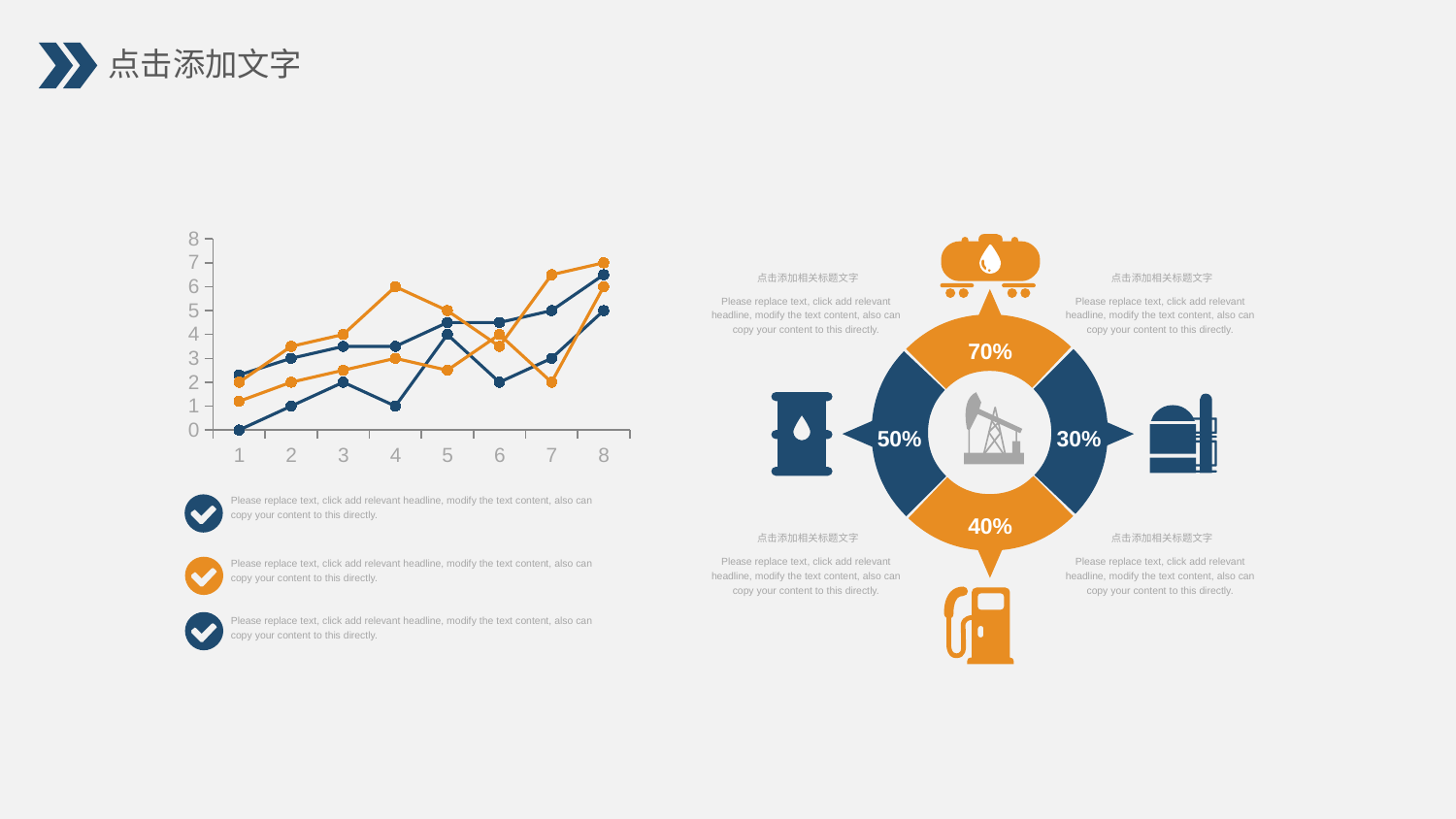
In the line chart on the left, do the lines generally rise or fall from x = 1 to x = 8? rise In the ring diagram on the right, what is the difference between the top segment (70%) and the right segment (30%)? 40% In the ring diagram on the right, what percentage is shown in the top segment? 70% In the line chart on the left, is the lowest value at x = 1 greater or less than 1? less In the line chart on the left, what is the highest value shown on the y axis? 8 What kind of chart is shown on the left side of the slide? line chart In the ring diagram on the right, which segment shows the smallest percentage? the right segment (30%) In the line chart on the left, is the highest value at x = 8 greater or less than 6? greater In the line chart on the left, how many lines are plotted? 4 In the line chart on the left, is the highest value at x = 4 greater or less than 5? greater In the line chart on the left, how many points are labelled along the x axis? 8 In the ring diagram on the right, which is larger, the left segment or the bottom segment? the left segment (50%)